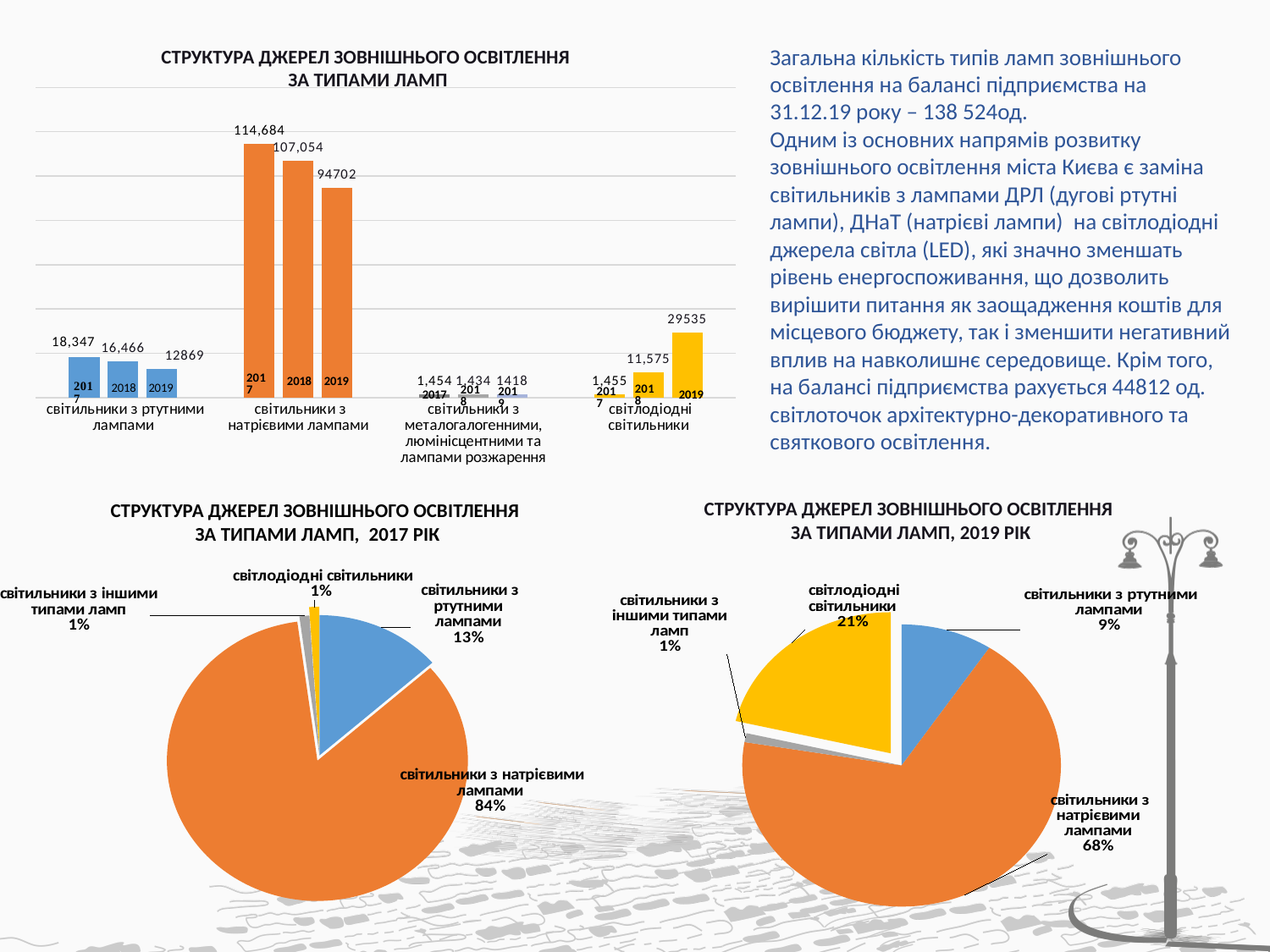
In the top-left bar chart, do the values for світлодіодні світильники rise or fall from 2017 to 2019? rise In the top-left bar chart, what is the value for світильники з натрієвими лампами in 2017? 114,684 In the top-left bar chart, what is the value for світильники з ртутними лампами in 2018? 16,466 In the top-left bar chart, how many categories are shown on the x axis? 4 In the top-left bar chart, what is the difference between the 2017 and 2019 values for світильники з ртутними лампами? 5,478 In the top-left bar chart, what is the value for світлодіодні світильники in 2019? 29535 In the pie chart for 2017 рік, what share do світильники з натрієвими лампами have? 84% What kind of chart is the top-left chart titled 'СТРУКТУРА ДЖЕРЕЛ ЗОВНІШНЬОГО ОСВІТЛЕННЯ ЗА ТИПАМИ ЛАМП'? bar chart In the top-left bar chart, which category has the highest value in 2019? світильники з натрієвими лампами In the pie chart for 2019 рік, what share do світлодіодні світильники have? 21% In the top-left bar chart, which category has the lowest value in 2019? світильники з металогалогенними, люмінісцентними та лампами розжарення Which is larger: the share of світильники з ртутними лампами in the 2017 pie chart or in the 2019 pie chart? 2017 (13%)